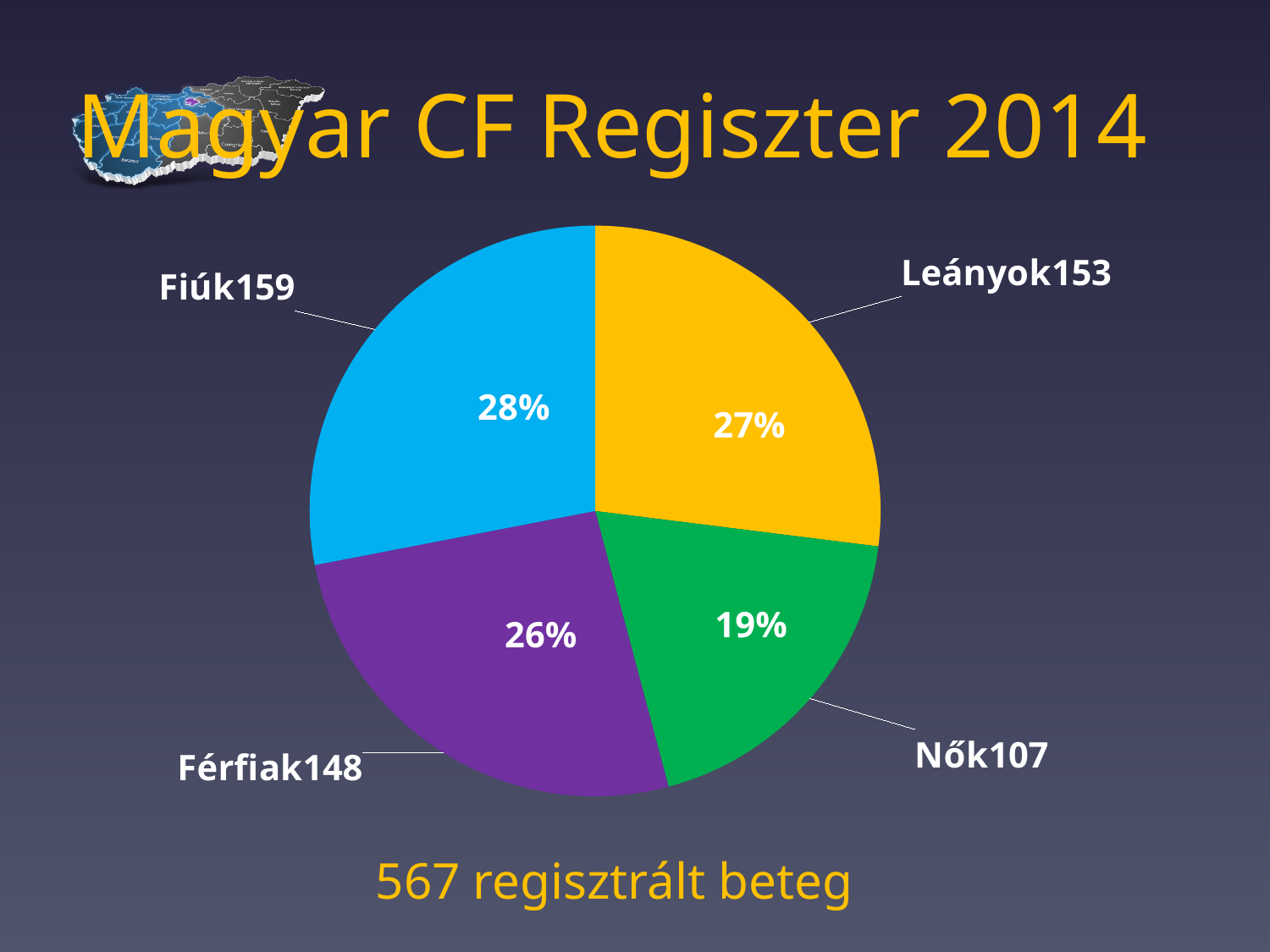
What count is shown for Leányok? 153 What count is shown for Férfiak? 148 What kind of chart is shown on the slide? pie chart What share of the pie does the Nők slice represent? 19% Which is larger, the count for Leányok or the count for Férfiak? Leányok How many slices does the pie chart have? 4 What is the difference between the counts for Fiúk and Nők? 52 What share of the pie does the Fiúk slice represent? 28% Which category has the largest slice of the pie? Fiúk What share of the pie does the Férfiak slice represent? 26% What colour is the Nők slice of the pie? green Which category has the smallest slice of the pie? Nők